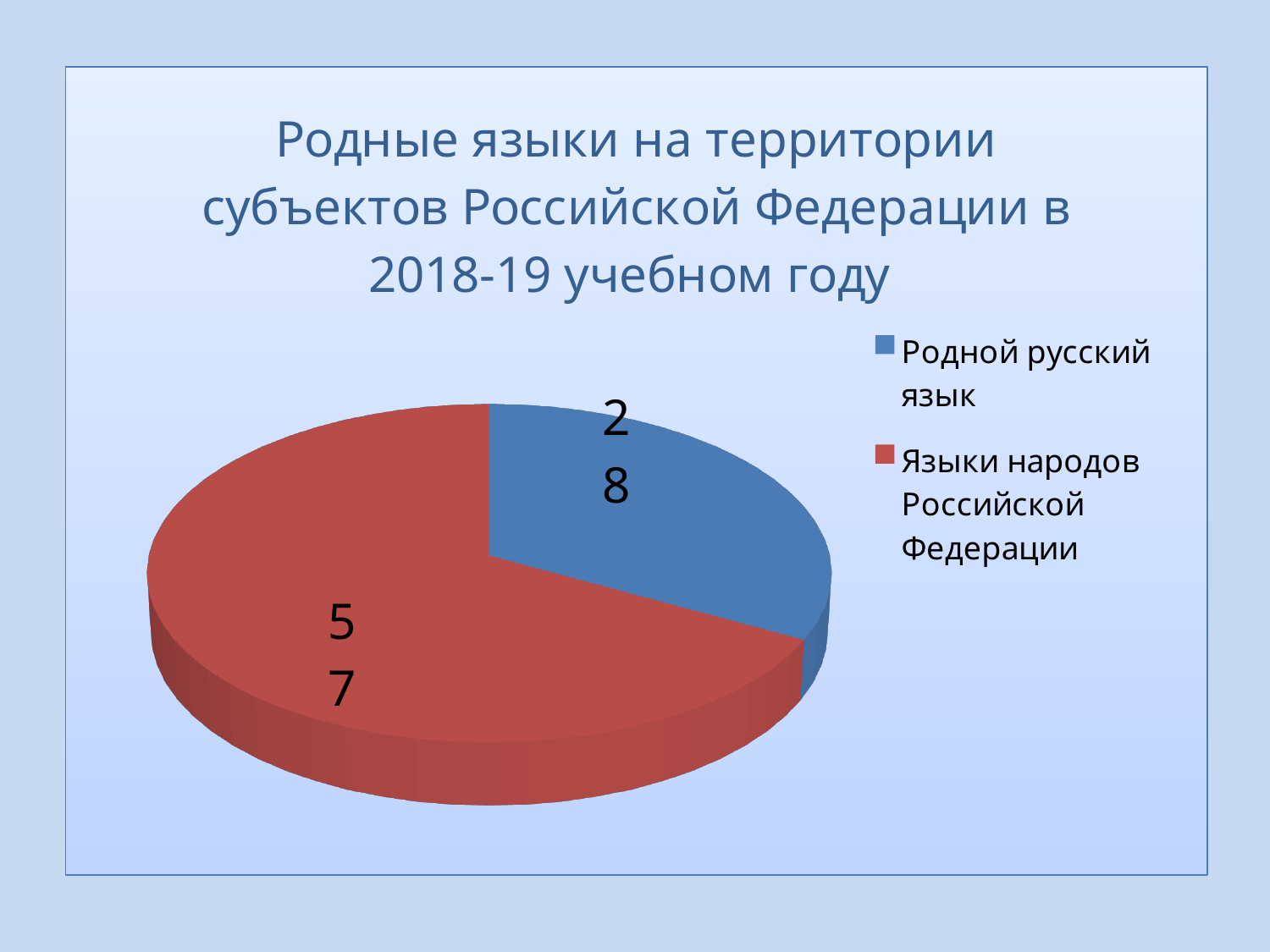
Which category has the smallest slice of the pie? Родной русский язык What colour is the slice for "Родной русский язык"? Blue What is the difference between the values for "Языки народов Российской Федерации" and "Родной русский язык"? 29 How many slices does the pie chart have? 2 Which is larger: the value for "Родной русский язык" or the value for "Языки народов Российской Федерации"? Языки народов Российской Федерации Which category has the largest slice of the pie? Языки народов Российской Федерации What value is shown for the slice "Родной русский язык"? 28 What kind of chart is shown on the slide? Pie chart How many entries does the legend list? 2 What is the sum of the two values shown on the pie chart? 85 What value is shown for the slice "Языки народов Российской Федерации"? 57 What is the title of the chart? Родные языки на территории субъектов Российской Федерации в 2018-19 учебном году